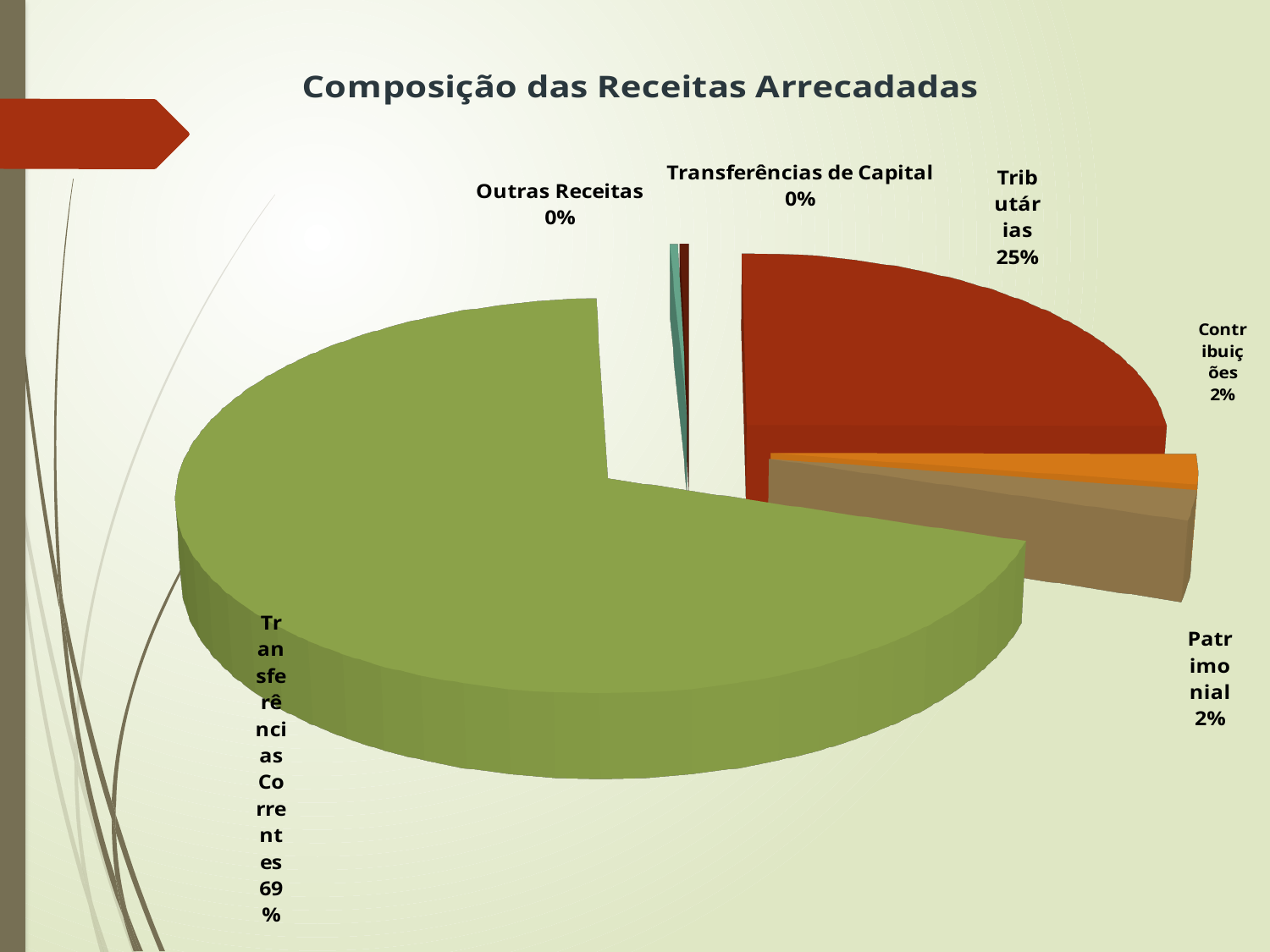
What percentage is shown for Patrimonial? 2% What percentage is shown for Contribuições? 2% What kind of chart is shown on the slide? Pie chart What is the title of the chart? Composição das Receitas Arrecadadas What share of the pie is Transferências Correntes? 69% What share of the pie is Tributárias? 25% Which is larger, the share for Tributárias or the share for Contribuições? Tributárias Which category has the largest share of the pie? Transferências Correntes What percentage is shown for Transferências de Capital? 0% What percentage is shown for Outras Receitas? 0% How many categories are shown in the pie chart? 6 What is the difference in percentage points between Transferências Correntes and Tributárias? 44